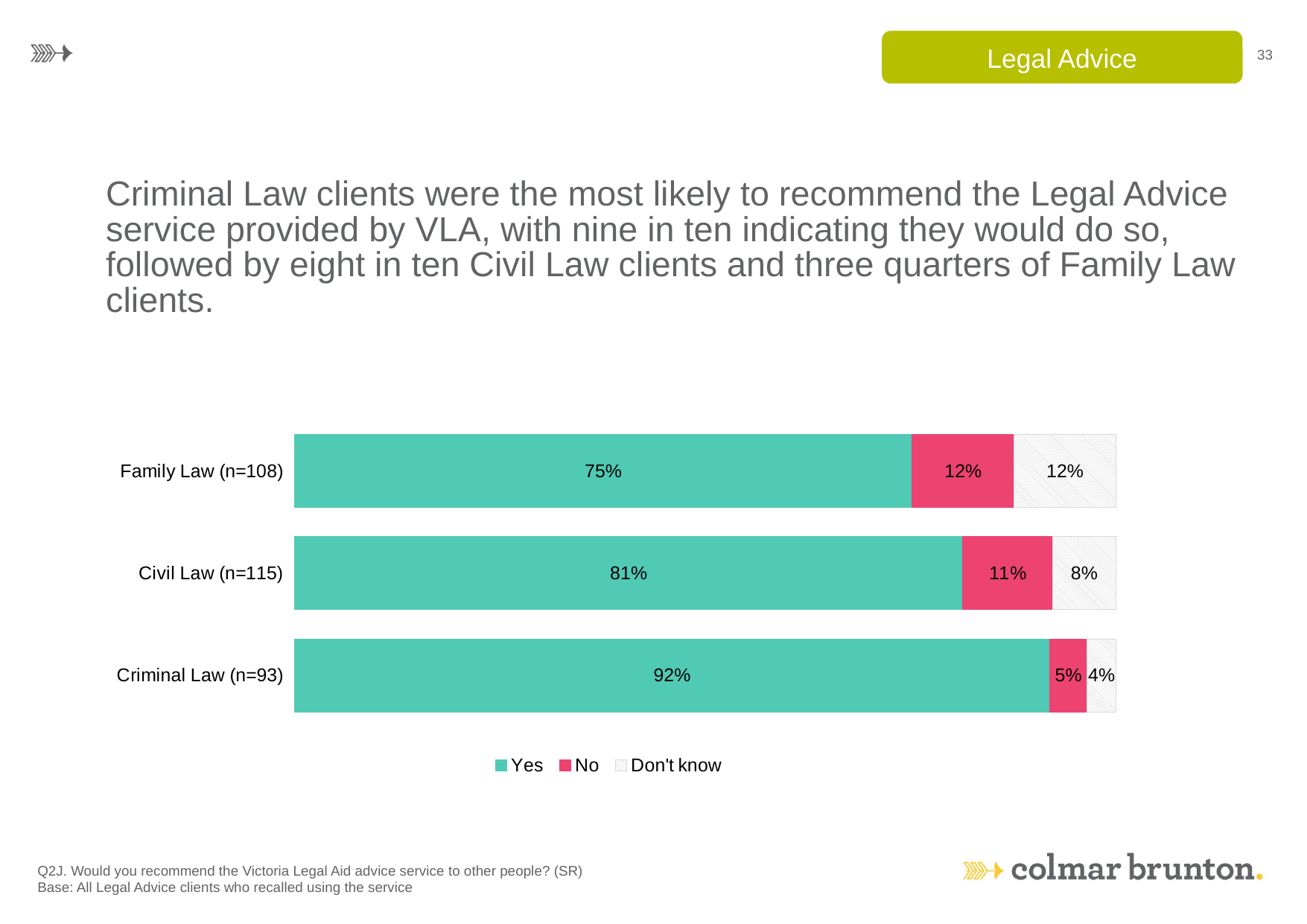
What percentage of Civil Law clients answered No? 11% Which category has the highest Yes percentage? Criminal Law (n=93) Which colour represents the No responses in the chart? Pink/red What is the total of the Civil Law bar (Yes + No + Don't know)? 100% What percentage of Criminal Law clients answered Don't know? 4% How many categories are shown in the chart? 3 What is the difference in Yes percentage between Criminal Law and Family Law clients? 17 percentage points Which category has the lowest No percentage? Criminal Law (n=93) What percentage of Family Law clients answered Yes? 75% Which is larger: the Don't know percentage for Family Law or for Civil Law? Family Law What kind of chart is shown on the slide? Stacked bar chart How many series does the legend list? 3